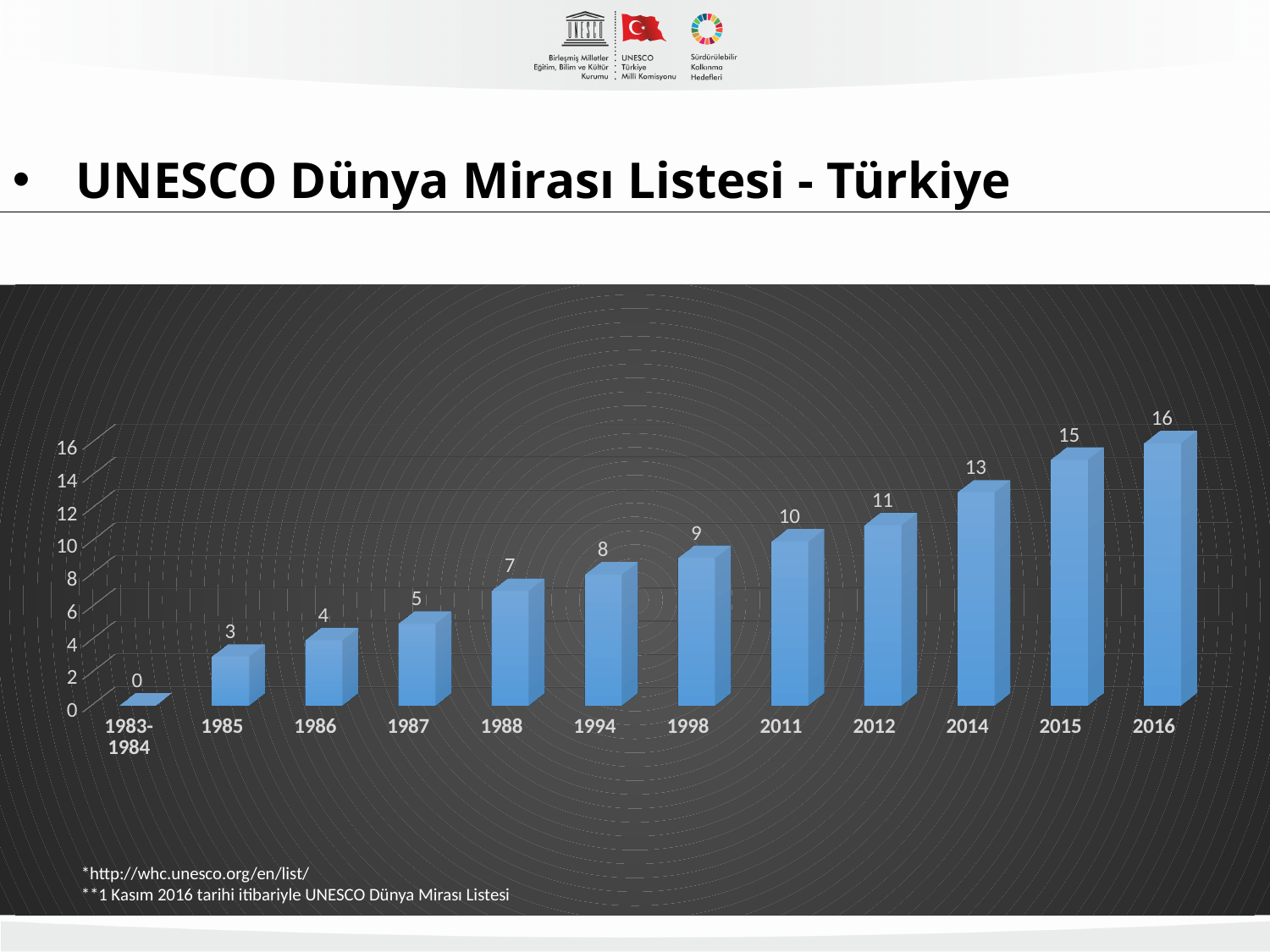
How many categories are shown on the x axis? 12 Which category has the lowest value? 1983-1984 What is the value for 2011? 10 What kind of chart is shown on the slide? bar chart What is the value for 1988? 7 Do the values rise or fall from left to right along the x axis? rise Which is larger, the value for 2012 or the value for 1994? 2012 Is the value for 2015 greater or less than 14? greater What is the difference between the values for 1998 and 1985? 6 What is the difference between the values for 2016 and 2014? 3 Which category has the highest value? 2016 What is the value for 1983-1984? 0